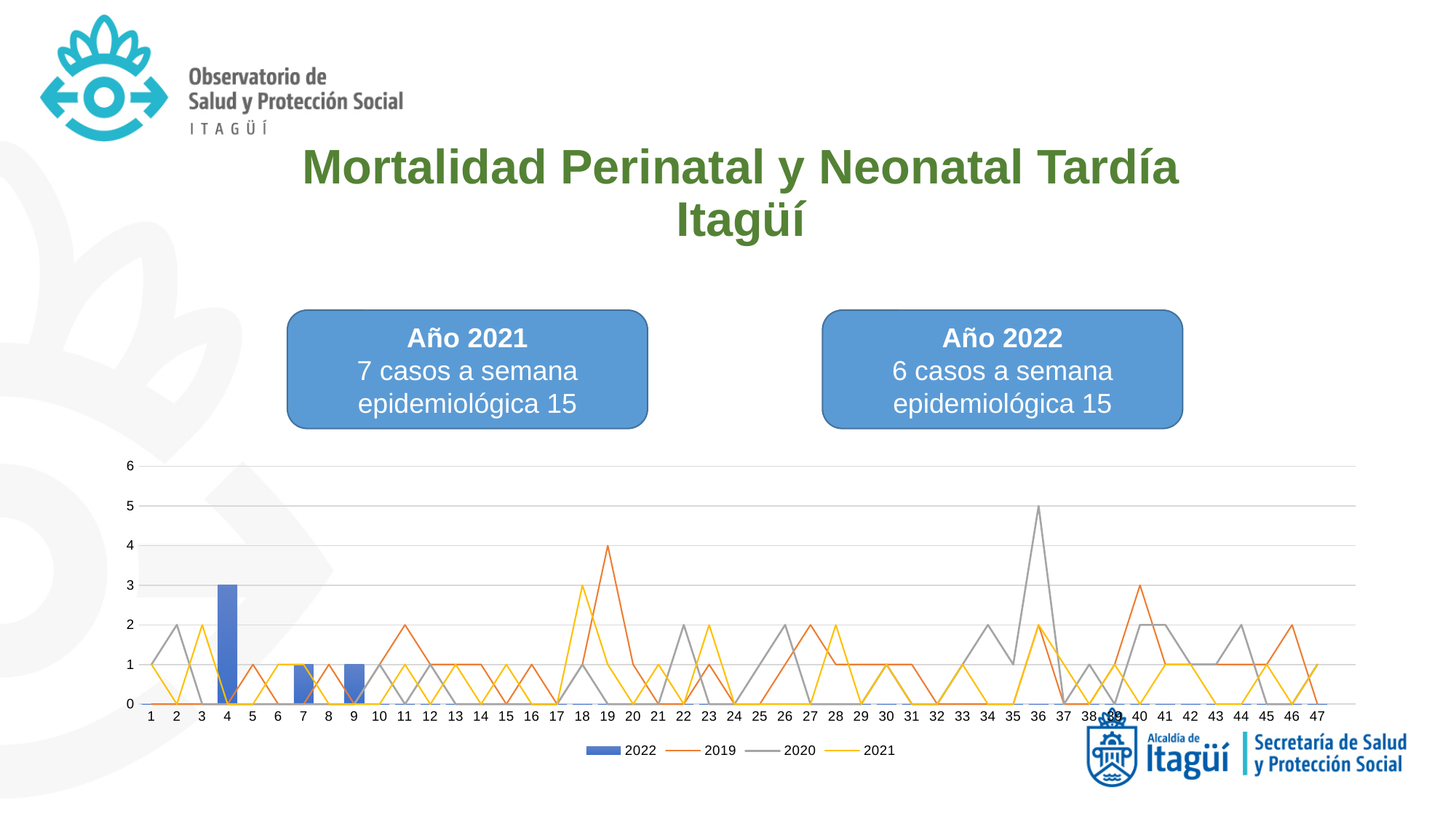
At week 4, which is larger: the 2022 bar or the 2020 line? 2022 What is the difference between the 2020 peak at week 36 and the 2019 peak at week 19? 1 Which series is plotted as bars rather than a line? 2022 In which week does the 2022 series reach its highest value? 4 In which week does the 2020 series reach its highest value? 36 Is the value of the 2020 series at week 36 greater or less than 4? greater What kind of chart is shown on the slide? A combined bar and line chart How many epidemiological weeks are shown on the x axis? 47 What is the value of the 2022 bar at week 4? 3 What is the value of the 2020 series at week 36? 5 What is the value of the 2019 series at week 19? 4 How many series does the legend list? 4